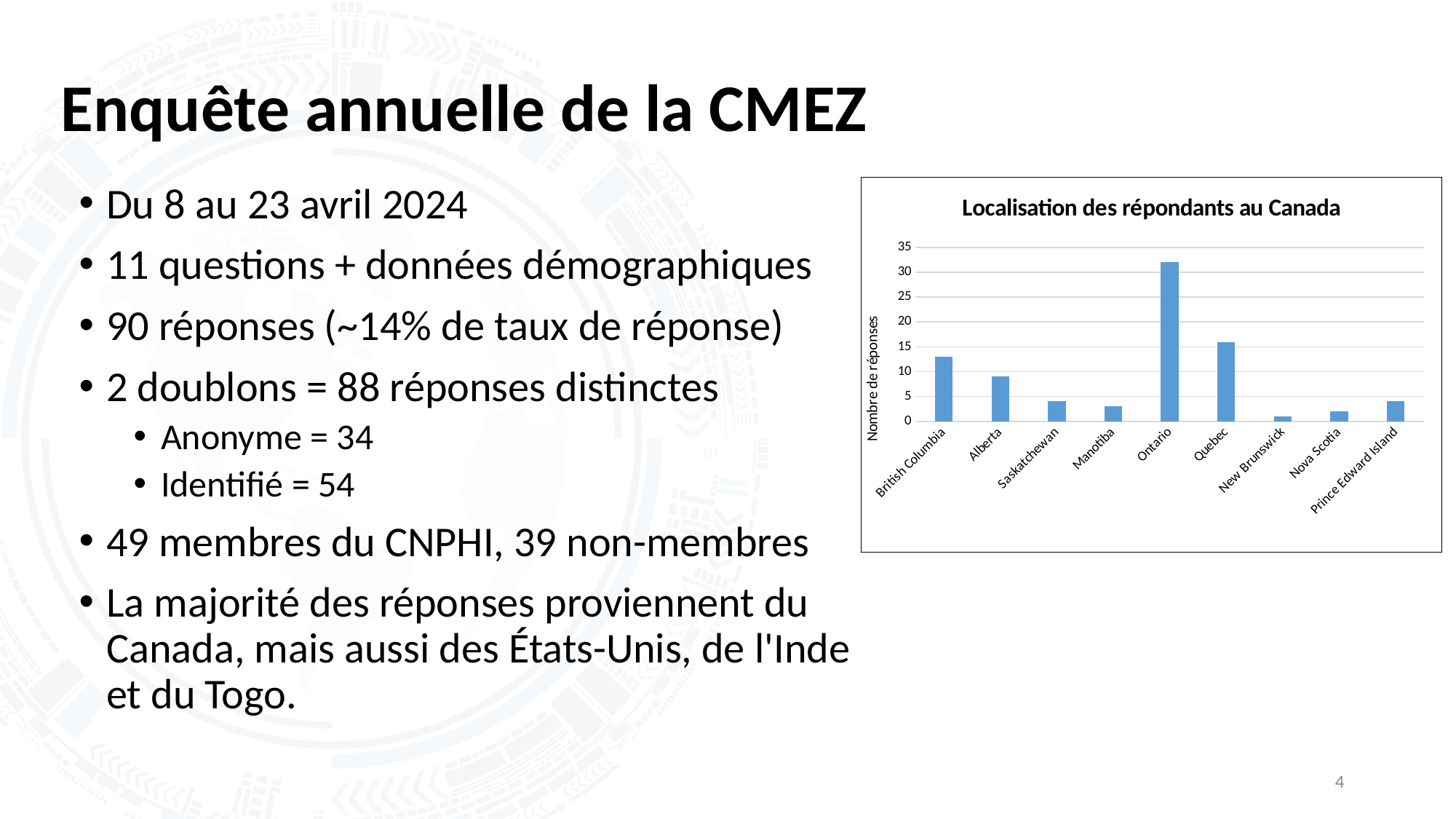
What type of chart is shown on the slide? bar chart What is the label of the y axis of the chart? Nombre de réponses Is the value for Quebec greater or less than 15? greater Which province has the lowest number of respondents? New Brunswick What is the title of the chart? Localisation des répondants au Canada Which has more respondents, Quebec or British Columbia? Quebec Is the value for British Columbia greater or less than 10? greater Which province has the highest number of respondents? Ontario Is the value for Manitoba greater or less than 5? less How many provinces are shown on the x axis of the chart? 9